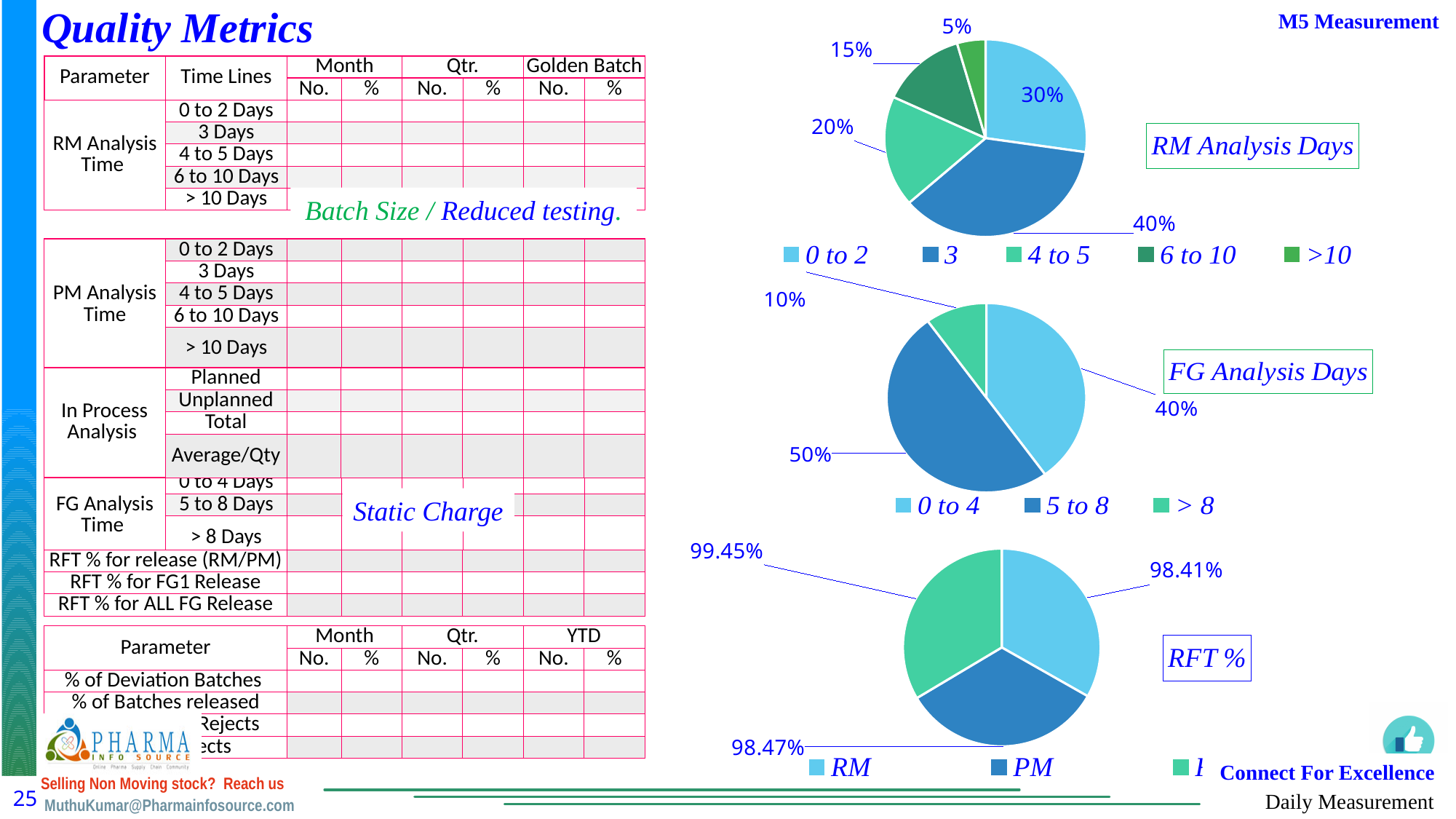
In the RM Analysis Days pie chart, which category has the smallest share? >10 In the RM Analysis Days pie chart, what is the difference between the '0 to 2' and '4 to 5' shares? 10% In the RM Analysis Days pie chart, what percentage is shown for the '3' slice? 40% What type of chart is used for RM Analysis Days? Pie chart In the FG Analysis Days pie chart, is the share for '0 to 4' larger or smaller than the share for '5 to 8'? smaller In the FG Analysis Days pie chart, what percentage is shown for '5 to 8'? 50% In the RM Analysis Days pie chart, which category has the largest share? 3 In the FG Analysis Days pie chart, which category has the smallest share? > 8 How many categories does the legend of the RM Analysis Days pie chart list? 5 How many slices does the FG Analysis Days pie chart have? 3 In the RM Analysis Days pie chart, what percentage is shown for the '6 to 10' slice? 15% In the RFT % pie chart, what value is shown for PM? 98.47%